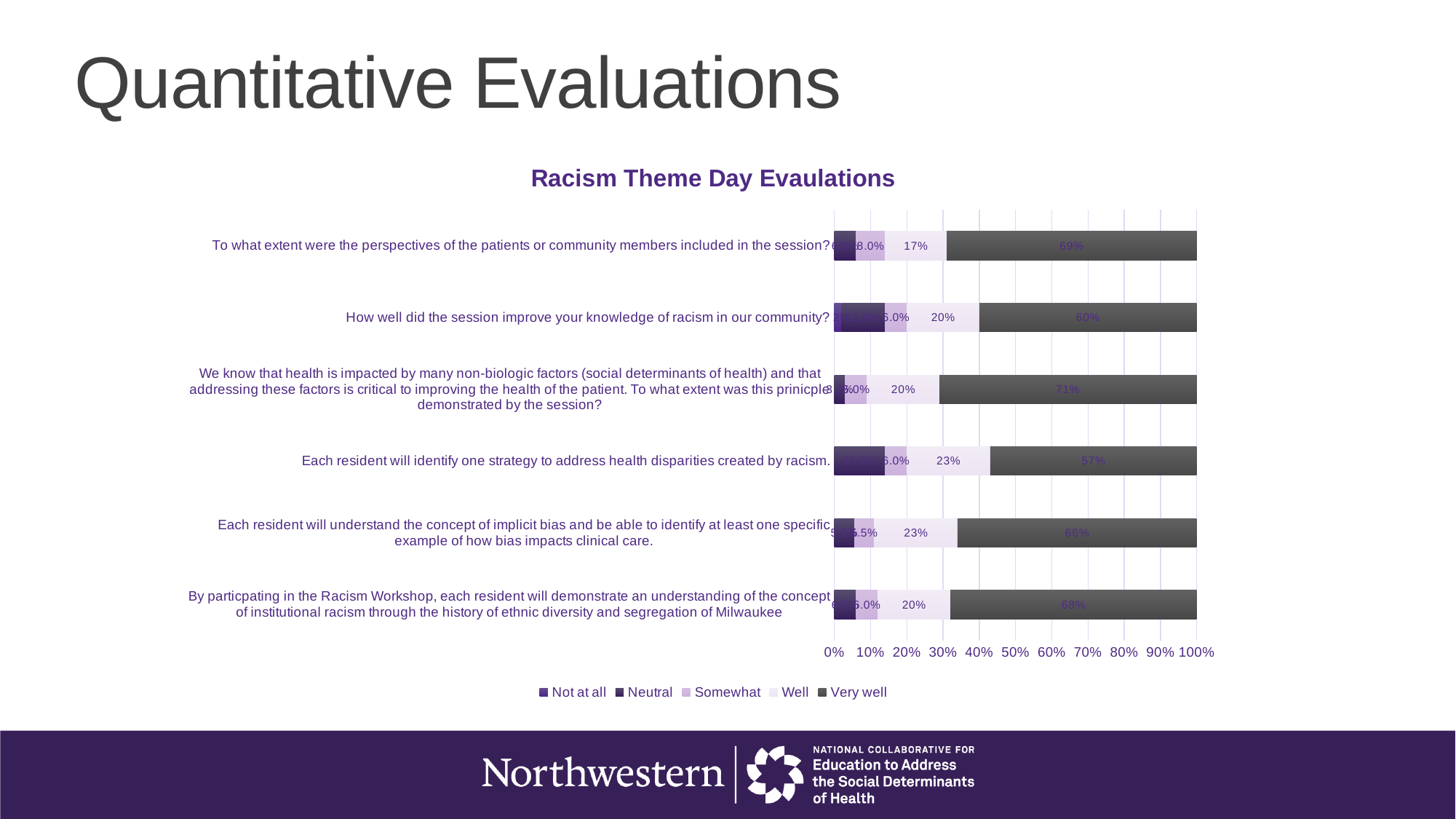
How many series does the legend list? 5 What is the difference between the 'Very well' values for the social determinants of health question (71%) and the 'identify one strategy' question (57%)? 14% What is the 'Well' value for 'Each resident will identify one strategy to address health disparities created by racism.'? 23% What is the 'Very well' value for 'How well did the session improve your knowledge of racism in our community?' 60% What is the title of the chart? Racism Theme Day Evaulations Which category has the lowest 'Very well' value? Each resident will identify one strategy to address health disparities created by racism. What is the 'Well' value for 'To what extent were the perspectives of the patients or community members included in the session?' 17% Which has a larger 'Very well' value: the implicit bias question or the institutional racism (Milwaukee) question? The institutional racism (Milwaukee) question How many questions (categories) are plotted on the chart? 6 What type of chart is shown on the slide? Stacked bar chart What is the 'Very well' value for 'To what extent were the perspectives of the patients or community members included in the session?' 69%